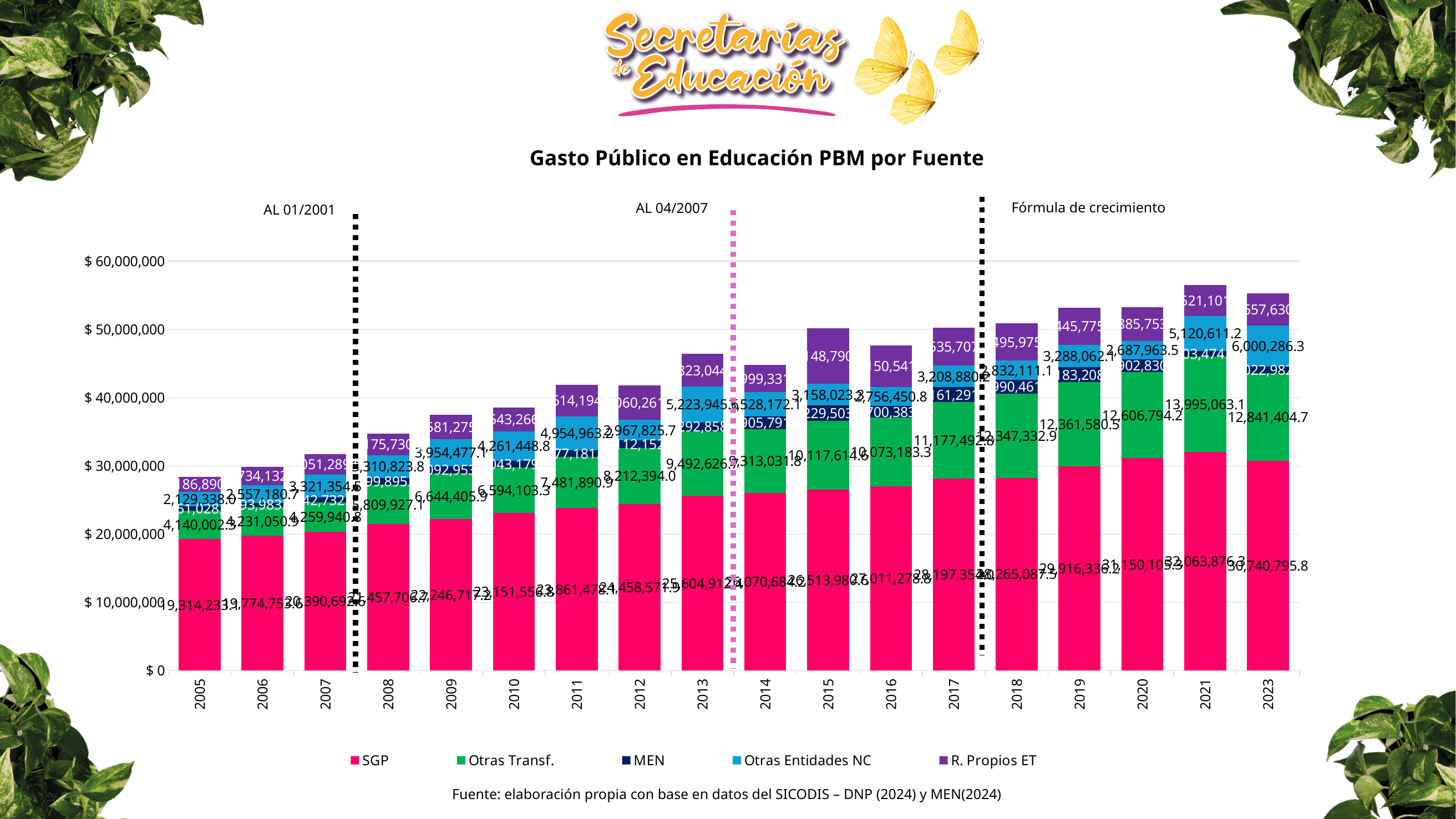
Is the total stacked value for 2005 greater or less than 30,000,000? less What kind of chart is shown on the slide? Stacked bar chart What is the Otras Transf. value for 2021? 13,995,063.1 What is the Otras Transf. value for 2023? 12,841,404.7 What is the SGP value for 2021? 32,063,876.3 What is the Otras Transf. value for 2012? 8,212,394.0 What is the difference between the Otras Transf. values for 2021 and 2023? 1,153,658.4 How many years are shown on the x axis? 18 Does the SGP series generally rise or fall from 2005 to 2023? Rise Which year has the shortest stacked bar overall? 2005 How many series does the legend list? 5 Which year has the tallest stacked bar overall? 2021